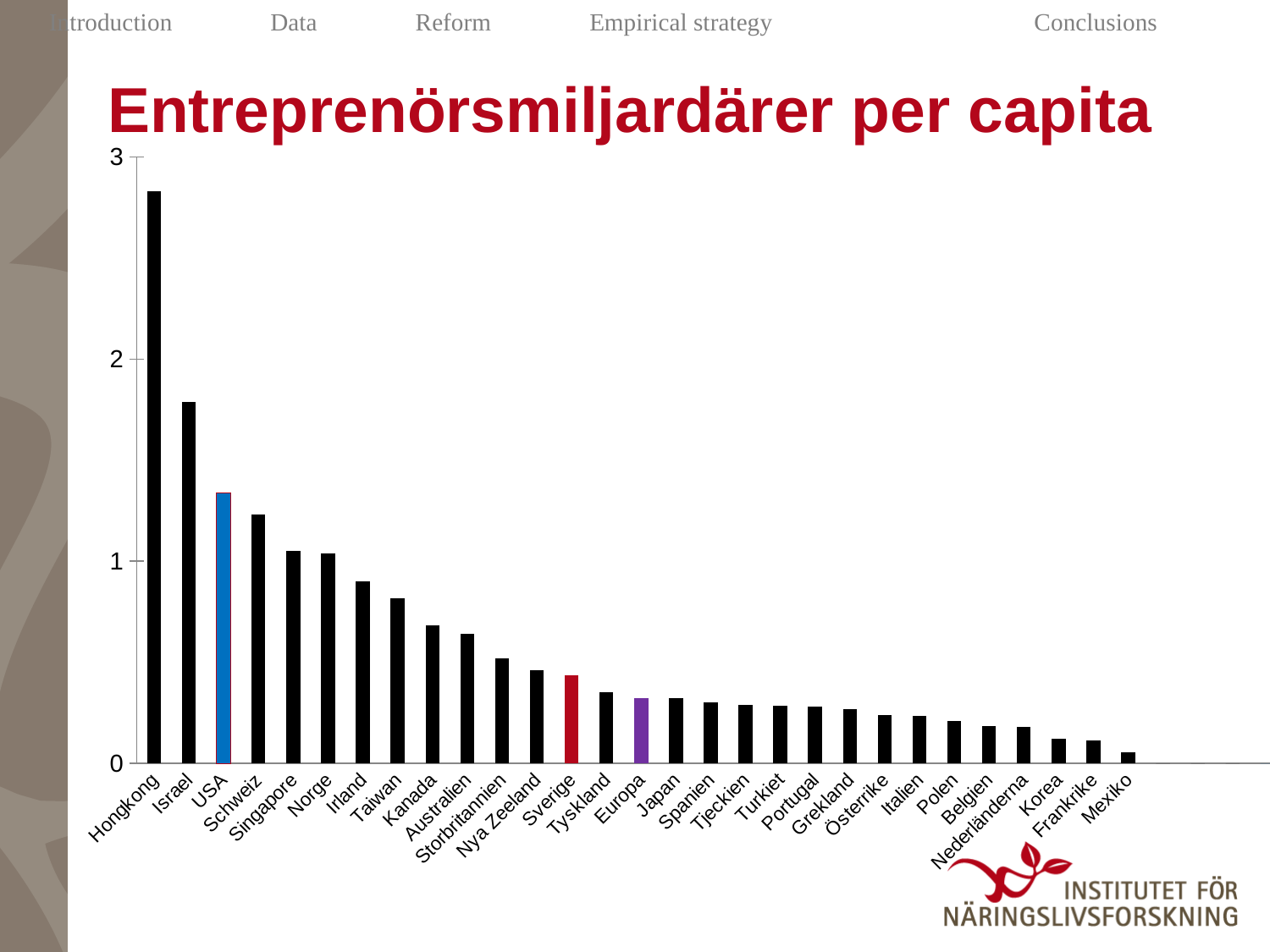
Which country has the lowest value in the chart? Mexiko Is the value for Israel greater or less than 2? less Is the value for USA greater or less than 1? greater Is the value for Sverige greater or less than 1? less What kind of chart is shown on the slide? bar chart How many countries/regions are shown on the x axis? 29 Which country has the highest number of entrepreneur billionaires per capita? Hongkong Do the values rise or fall from left to right along the x axis? fall Which has a higher value, Schweiz or Tyskland? Schweiz Which has a higher value, Israel or USA? Israel What colour is the bar for USA? blue